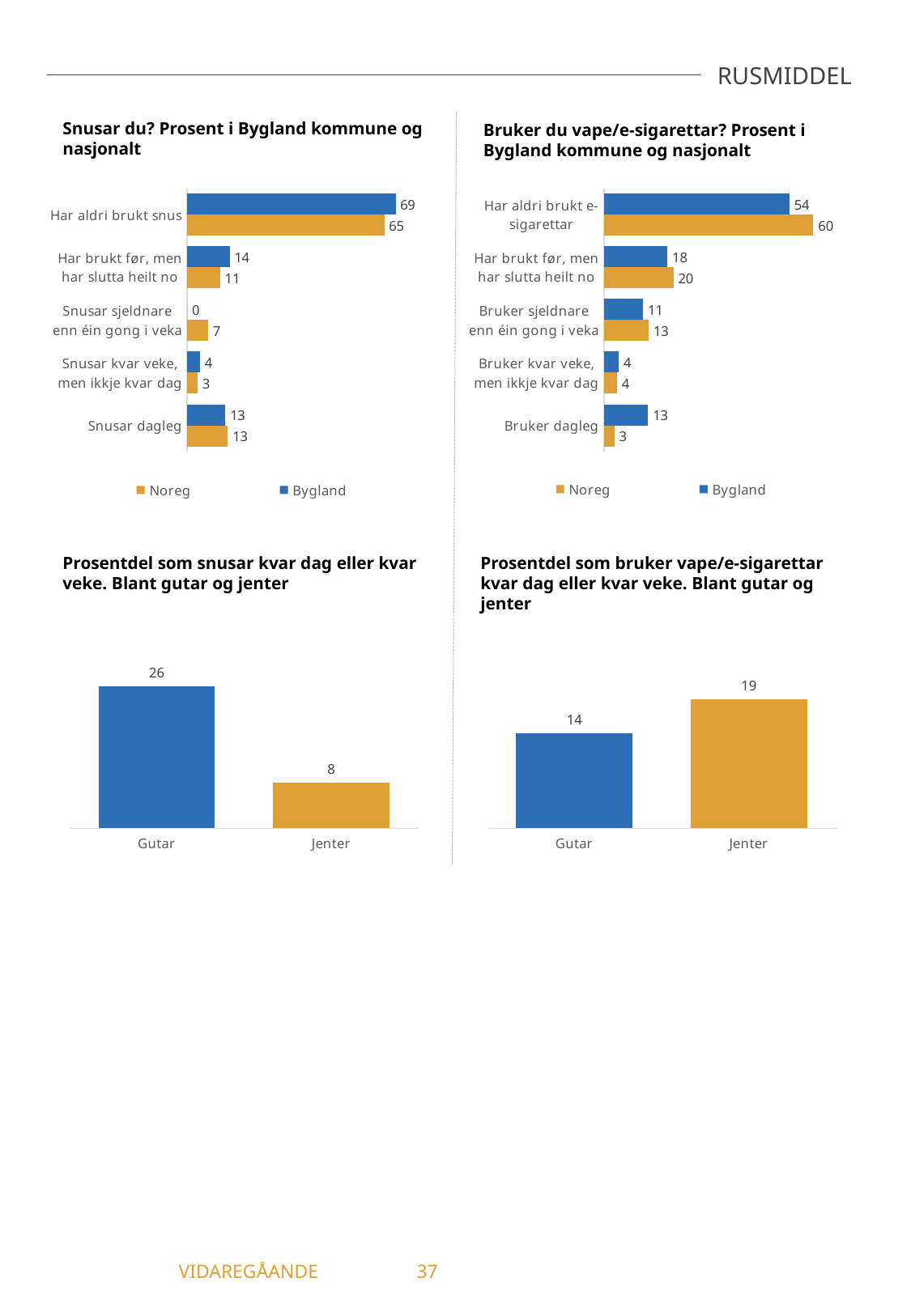
In the chart 'Bruker du vape/e-sigarettar? Prosent i Bygland kommune og nasjonalt', how many categories are shown? 5 In the chart 'Snusar du? Prosent i Bygland kommune og nasjonalt', what is the difference between the Bygland and Noreg values for 'Har brukt før, men har slutta heilt no'? 3 In the chart 'Prosentdel som snusar kvar dag eller kvar veke. Blant gutar og jenter', what is the difference between Gutar and Jenter? 18 In the chart 'Snusar du? Prosent i Bygland kommune og nasjonalt', how many series does the legend list? 2 In the chart 'Bruker du vape/e-sigarettar? Prosent i Bygland kommune og nasjonalt', what is the Noreg value for 'Har aldri brukt e-sigarettar'? 60 What kind of chart is 'Prosentdel som bruker vape/e-sigarettar kvar dag eller kvar veke. Blant gutar og jenter'? Bar chart In the chart 'Prosentdel som snusar kvar dag eller kvar veke. Blant gutar og jenter', what is the value for Gutar? 26 In the chart 'Snusar du? Prosent i Bygland kommune og nasjonalt', what is the Bygland value for 'Har aldri brukt snus'? 69 In the chart 'Bruker du vape/e-sigarettar? Prosent i Bygland kommune og nasjonalt', which category has the highest Bygland value? Har aldri brukt e-sigarettar In the chart 'Prosentdel som bruker vape/e-sigarettar kvar dag eller kvar veke. Blant gutar og jenter', which group has the higher value? Jenter In the chart 'Bruker du vape/e-sigarettar? Prosent i Bygland kommune og nasjonalt', which is larger for 'Bruker dagleg': Bygland or Noreg? Bygland In the chart 'Snusar du? Prosent i Bygland kommune og nasjonalt', what is the Noreg value for 'Snusar sjeldnare enn éin gong i veka'? 7